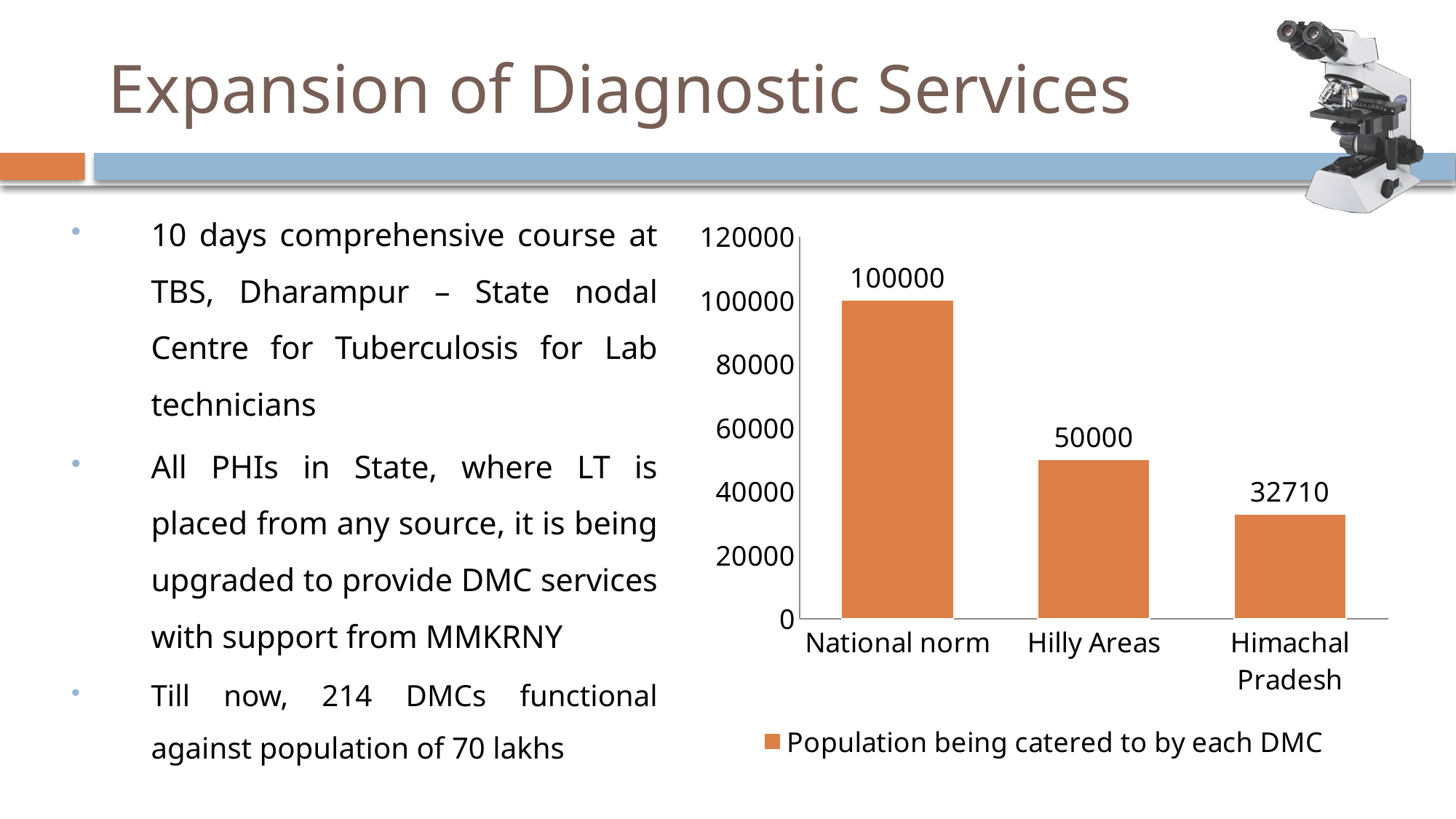
Which is larger, the value for Hilly Areas or the value for Himachal Pradesh? Hilly Areas Which category has the highest value? National norm What kind of chart is shown on the slide? bar chart What series name does the legend show? Population being catered to by each DMC Which category has the lowest value? Himachal Pradesh What is the value for Hilly Areas? 50000 What is the value for Himachal Pradesh? 32710 What is the difference between the values for National norm and Hilly Areas? 50000 Is the value for Himachal Pradesh greater or less than 40000? less What is the value for National norm? 100000 What is the difference between the values for Hilly Areas and Himachal Pradesh? 17290 How many categories are shown on the x axis? 3